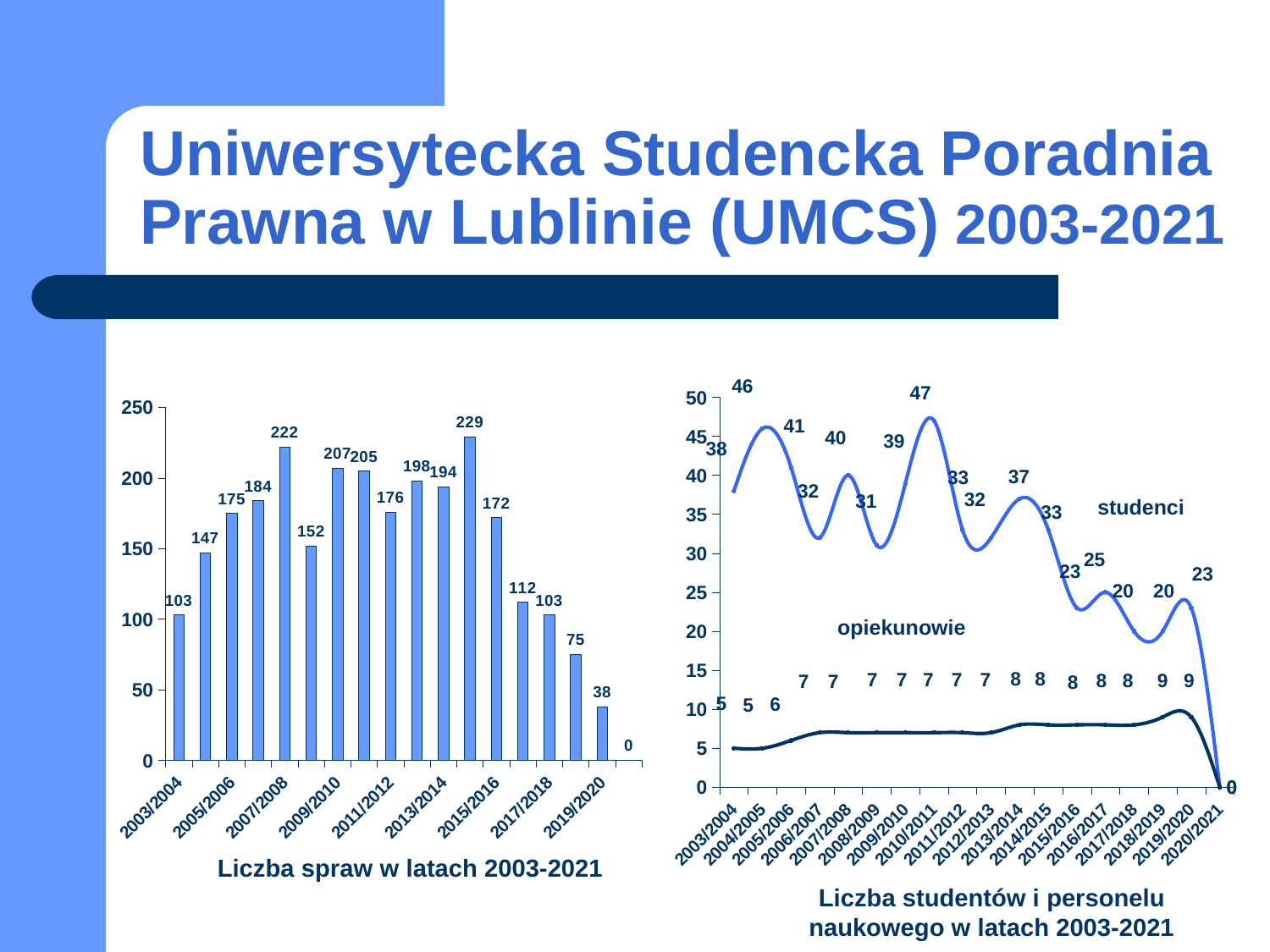
In the left chart 'Liczba spraw w latach 2003-2021', what is the value for 2019/2020? 38 In the left chart 'Liczba spraw w latach 2003-2021', which is larger, the value for 2005/2006 or the value for 2011/2012? 2011/2012 In the right chart 'Liczba studentów i personelu naukowego w latach 2003-2021', what is the value for studenci in 2010/2011? 47 In the right chart 'Liczba studentów i personelu naukowego w latach 2003-2021', what is the value for opiekunowie in 2019/2020? 9 What kind of chart is the left chart titled 'Liczba spraw w latach 2003-2021'? bar chart In the right chart 'Liczba studentów i personelu naukowego w latach 2003-2021', does the opiekunowie line generally rise or fall from 2003/2004 to 2019/2020? rise In the left chart 'Liczba spraw w latach 2003-2021', how many bars are plotted? 18 In the right chart 'Liczba studentów i personelu naukowego w latach 2003-2021', how many series are plotted? 2 In the right chart 'Liczba studentów i personelu naukowego w latach 2003-2021', what is the difference between studenci and opiekunowie in 2010/2011? 40 In the left chart 'Liczba spraw w latach 2003-2021', what is the difference between the values for 2009/2010 and 2015/2016? 35 In the left chart 'Liczba spraw w latach 2003-2021', what is the value for 2007/2008? 222 In the left chart 'Liczba spraw w latach 2003-2021', what is the highest value shown on any bar? 229